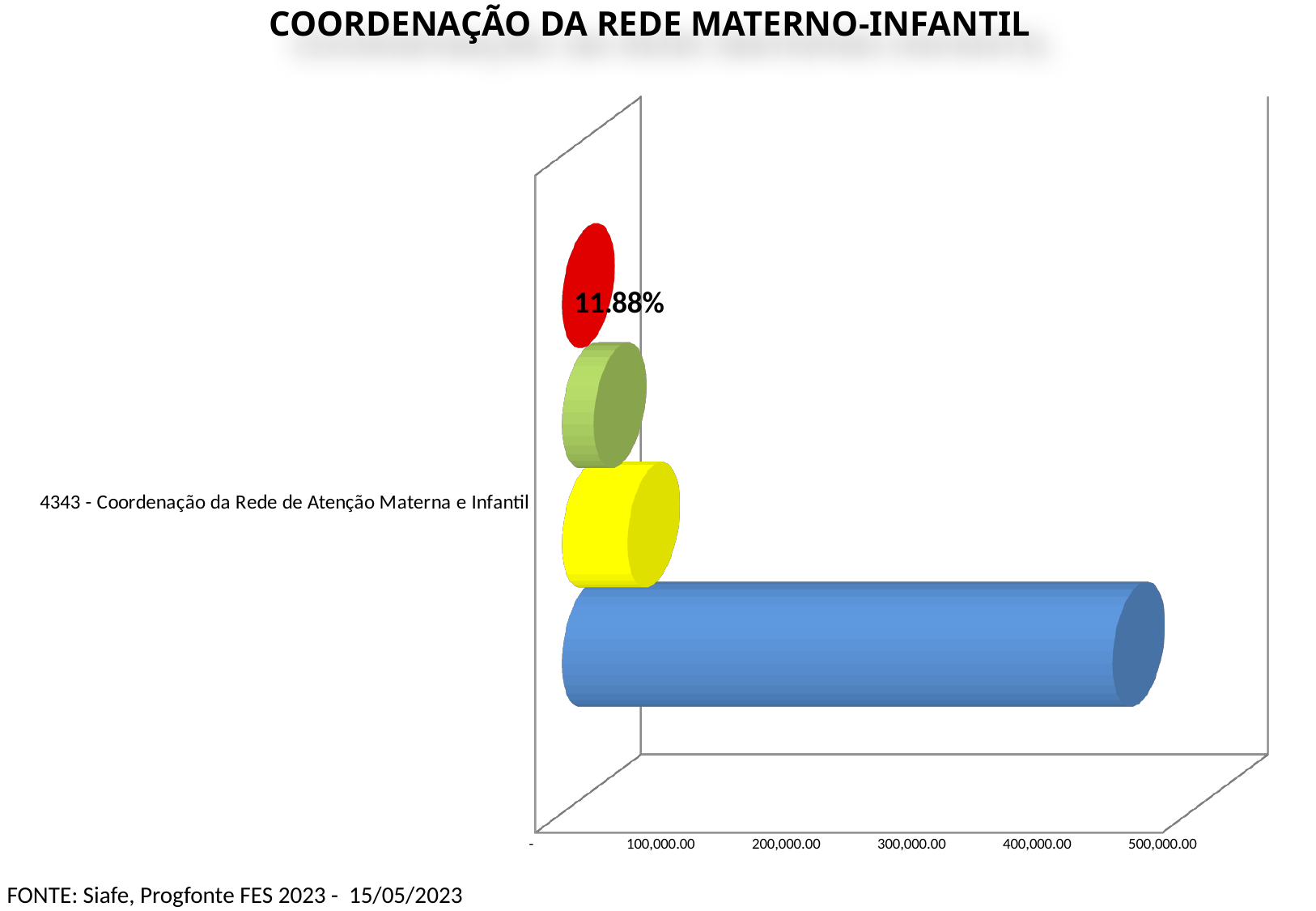
Which is larger, the blue bar or the yellow bar? blue bar What percentage value is printed as a data label on the chart? 11.88% What is the title of the chart? COORDENAÇÃO DA REDE MATERNO-INFANTIL What is the highest value shown on the horizontal axis of the chart? 500,000.00 How many categories are shown on the vertical axis of the chart? 1 What is the name of the category shown on the chart? 4343 - Coordenação da Rede de Atenção Materna e Infantil Is the value of the blue bar greater or less than 300,000.00? greater Is the value of the yellow bar greater or less than 200,000.00? less What kind of chart is shown on the slide? bar chart Which coloured bar is the longest on the chart? blue